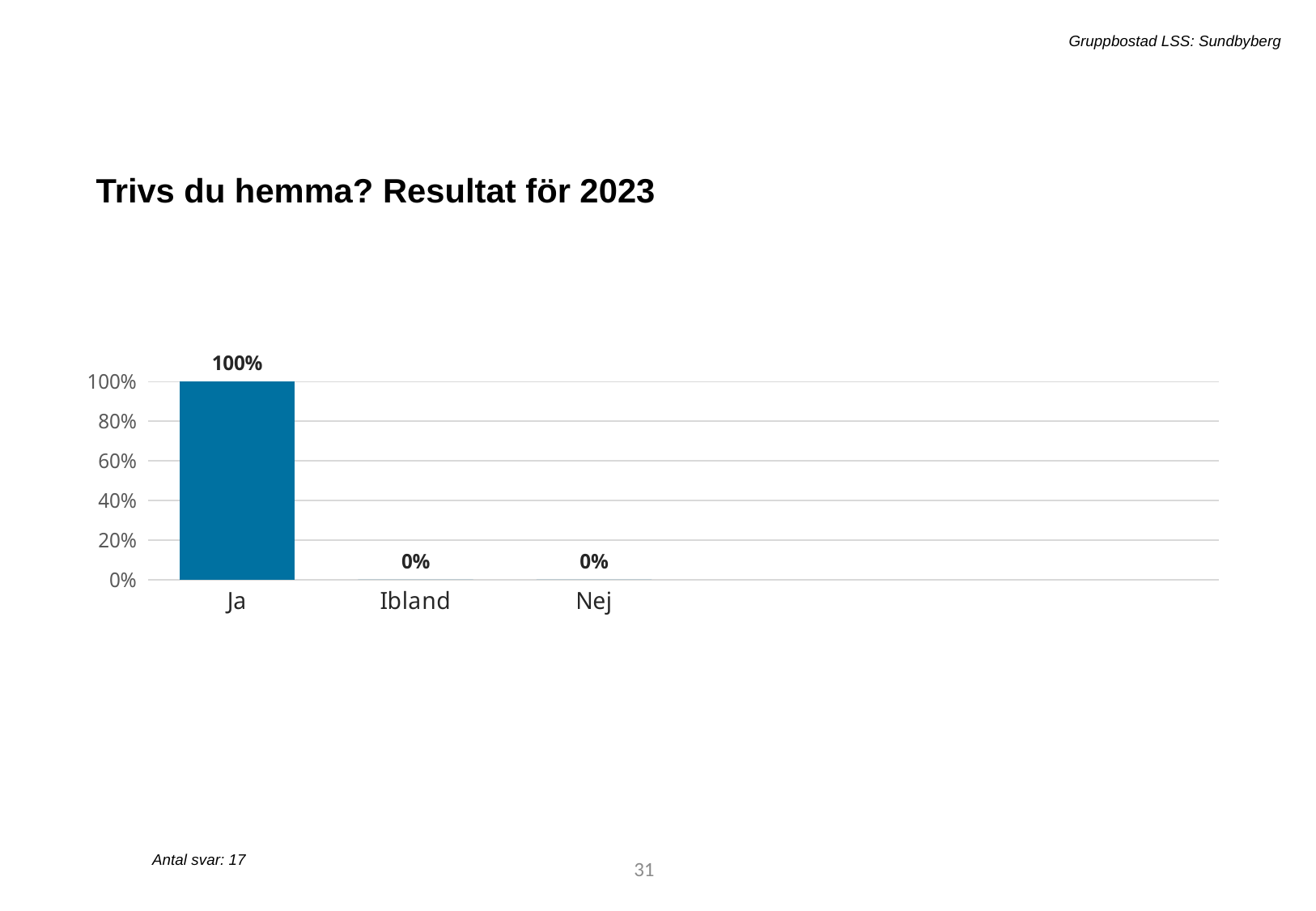
What is the number of responses (Antal svar) stated on the slide? 17 What is the value for Ja? 100% What is the value for Nej? 0% Which is larger, the value for Ja or the value for Ibland? Ja Is the value for Ja greater or less than 80%? greater What is the value for Ibland? 0% How many categories are shown on the x axis? 3 What kind of chart is shown on the slide? bar chart What is the title of the chart? Trivs du hemma? Resultat för 2023 Which category has the highest value? Ja What is the difference between the values for Ja and Nej? 100% What is the total of the values for Ja, Ibland and Nej? 100%